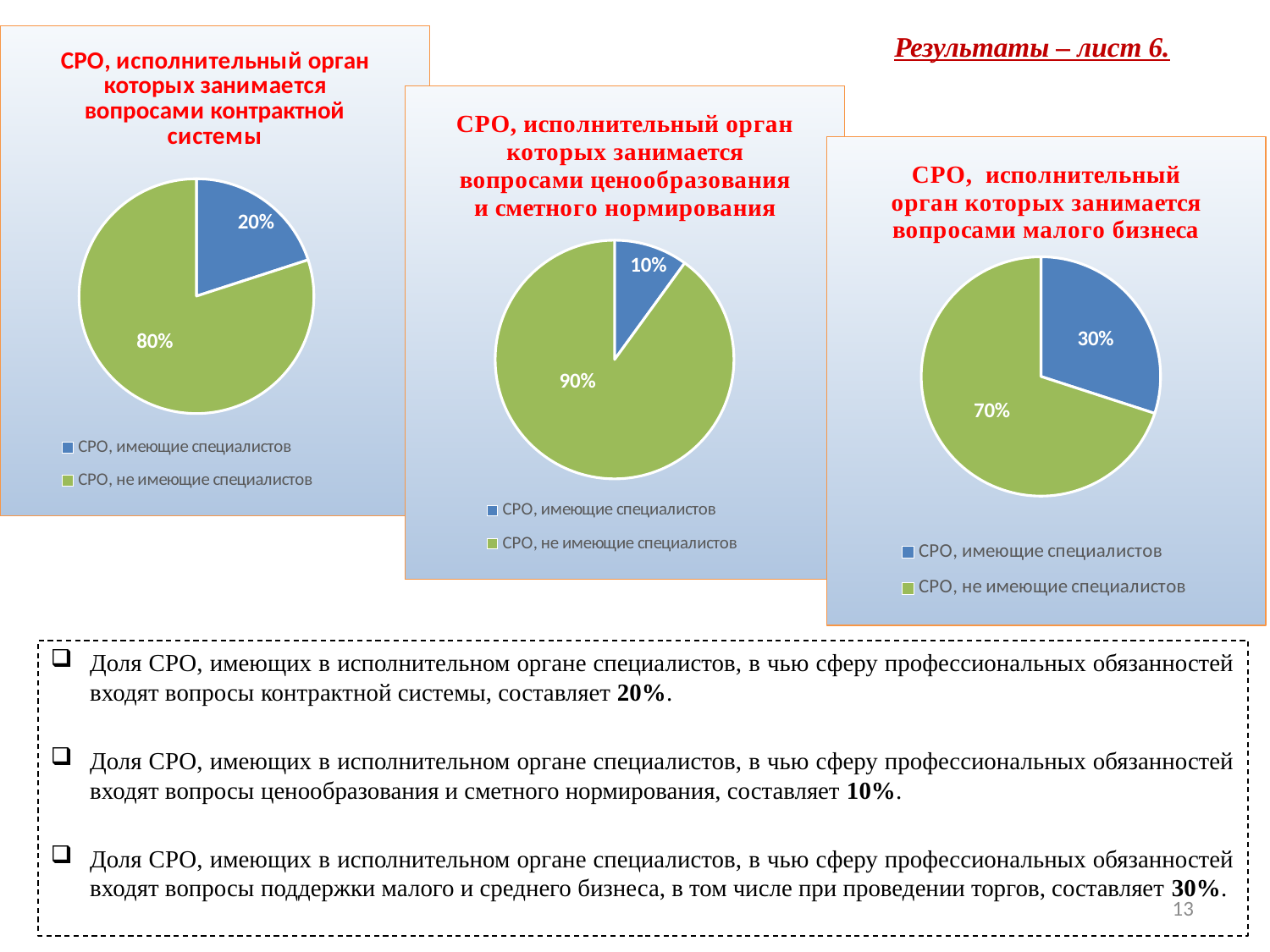
How many entries does the legend of the left pie chart (contract system) list? 2 In the right pie chart (small business), what share is labelled for 'СРО, не имеющие специалистов'? 70% In the right pie chart (small business), which slice is the largest? СРО, не имеющие специалистов In the left pie chart (contract system), what share is labelled for 'СРО, имеющие специалистов'? 20% Which is larger: the 'СРО, имеющие специалистов' share in the right pie chart (small business) or in the middle pie chart (pricing)? Right pie chart (small business) What type of chart is used on this slide? Pie chart In the left pie chart (contract system), what share is labelled for 'СРО, не имеющие специалистов'? 80% In the left pie chart (contract system), what is the difference in percentage points between the two slices? 60 In the right pie chart (small business), what share is labelled for 'СРО, имеющие специалистов'? 30% In the middle pie chart (pricing and estimate standardisation), what share is labelled for 'СРО, имеющие специалистов'? 10% In the middle pie chart (pricing and estimate standardisation), what share is labelled for 'СРО, не имеющие специалистов'? 90% In the middle pie chart (pricing and estimate standardisation), which slice is the smallest? СРО, имеющие специалистов